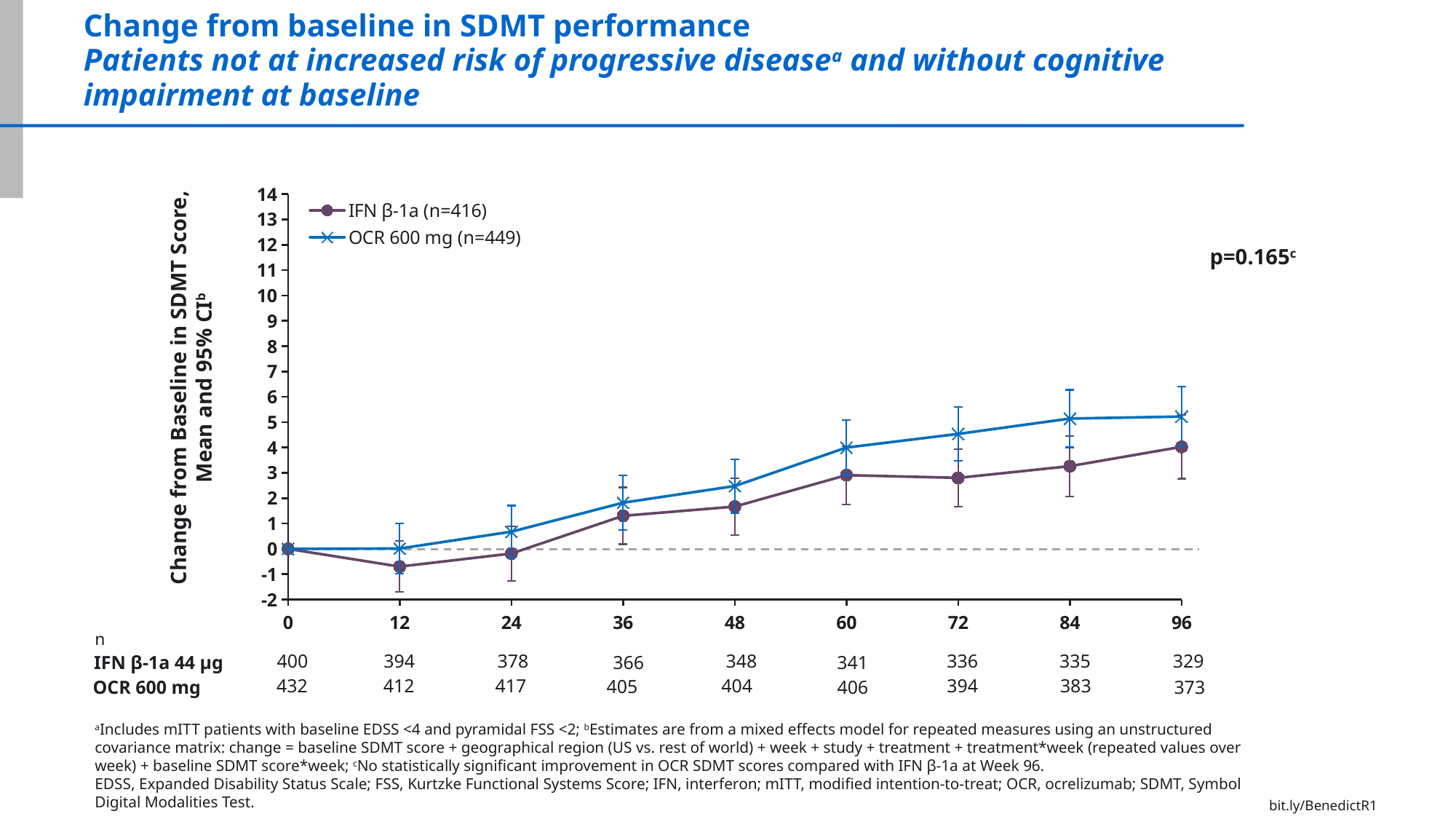
How many series does the legend list? 2 At week 96, which series has the higher change from baseline in SDMT score? OCR 600 mg (n=449) What is the n for IFN β-1a 44 µg at week 0 in the table below the chart? 400 What p-value is shown on the chart? p=0.165 Do the OCR 600 mg values generally rise or fall from week 0 to week 96? rise Is the value for OCR 600 mg at week 96 greater or less than 4? greater How many time points (weeks) are plotted along the x axis? 9 At which week is the IFN β-1a series at its lowest value? 12 Is the value for OCR 600 mg at week 60 greater or less than 3? greater What kind of chart is shown on the slide? line chart Is the value for IFN β-1a at week 12 greater or less than 0? less What is the change from baseline in SDMT score for OCR 600 mg at week 0? 0